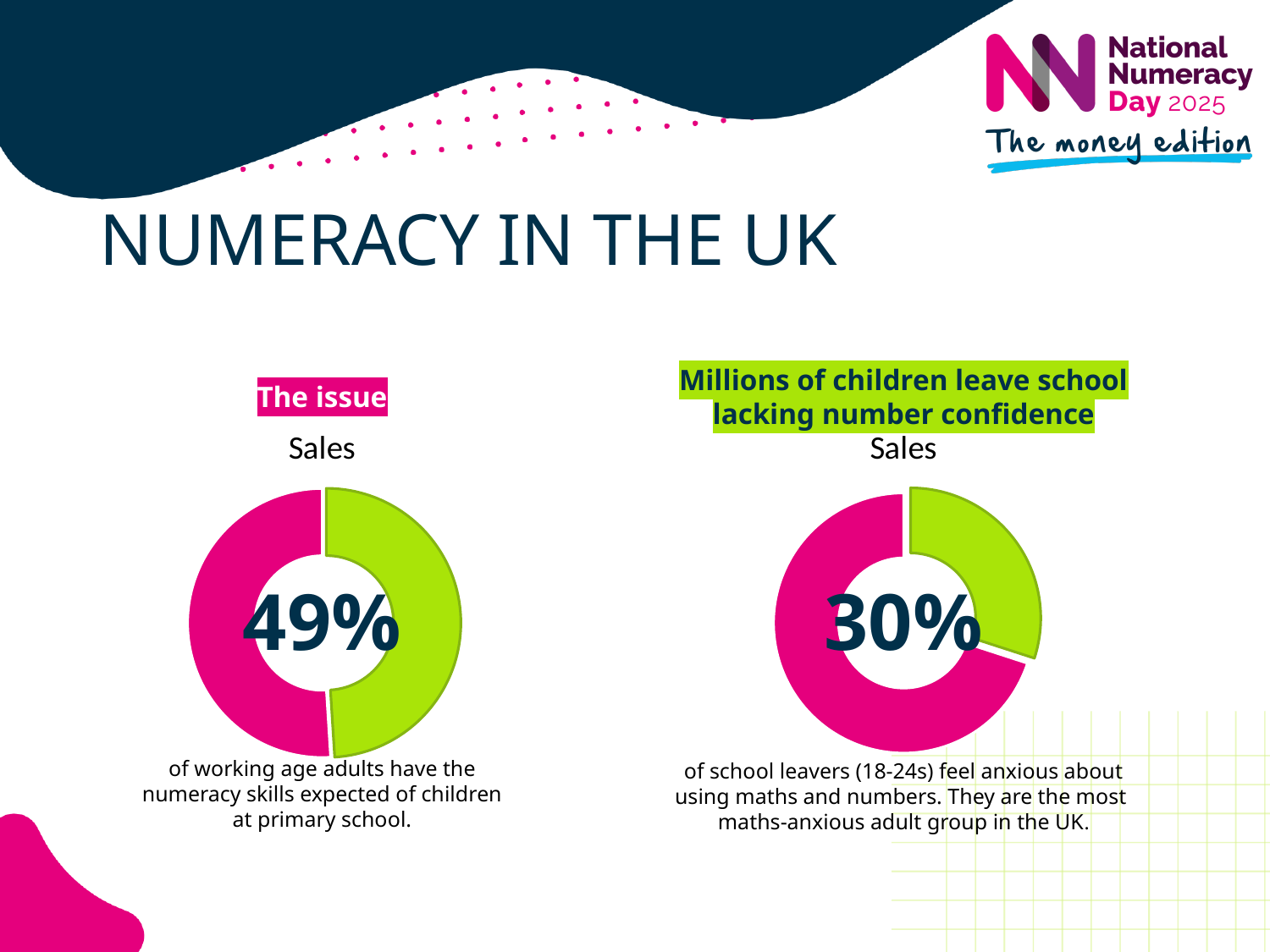
What is the difference between the percentage printed in the left chart and the percentage printed in the right chart? 19 percentage points What is the title printed above the right chart? Sales What kind of chart is shown on the right side of the slide? Doughnut chart What is the title printed above the left chart? Sales In the right chart, what share of the doughnut does the green slice represent? 30% What percentage is printed in the centre of the left chart? 49% In the right chart, which slice is larger, the pink one or the green one? Pink Which chart shows the larger printed percentage, the left chart or the right chart? Left chart How many slices does the right chart have? 2 What kind of chart is shown on the left side of the slide? Doughnut chart How many slices does the left chart have? 2 What percentage is printed in the centre of the right chart? 30%